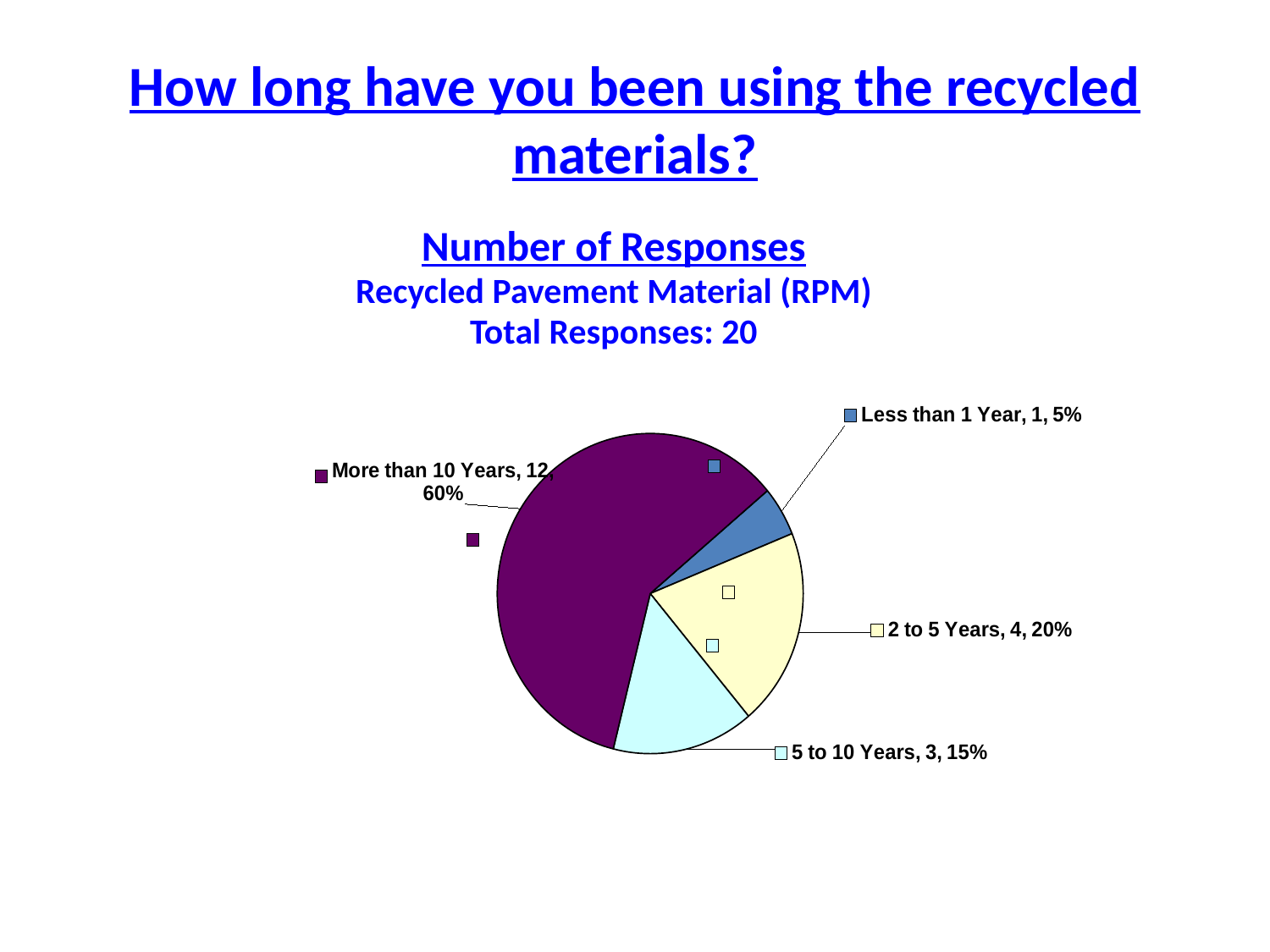
Which has more responses, '5 to 10 Years' or '2 to 5 Years'? 2 to 5 Years Which category has the fewest responses? Less than 1 Year How many categories does the pie chart have? 4 How many responses are in the 'More than 10 Years' category? 12 How many more responses does 'More than 10 Years' have than '2 to 5 Years'? 8 Which category has the most responses? More than 10 Years What percentage of responses is 'Less than 1 Year'? 5% What is the total number of responses shown on the slide? 20 What is the chart's title? Number of Responses What kind of chart is shown on the slide? pie chart What percentage of responses is '2 to 5 Years'? 20% How many responses are in the '5 to 10 Years' category? 3